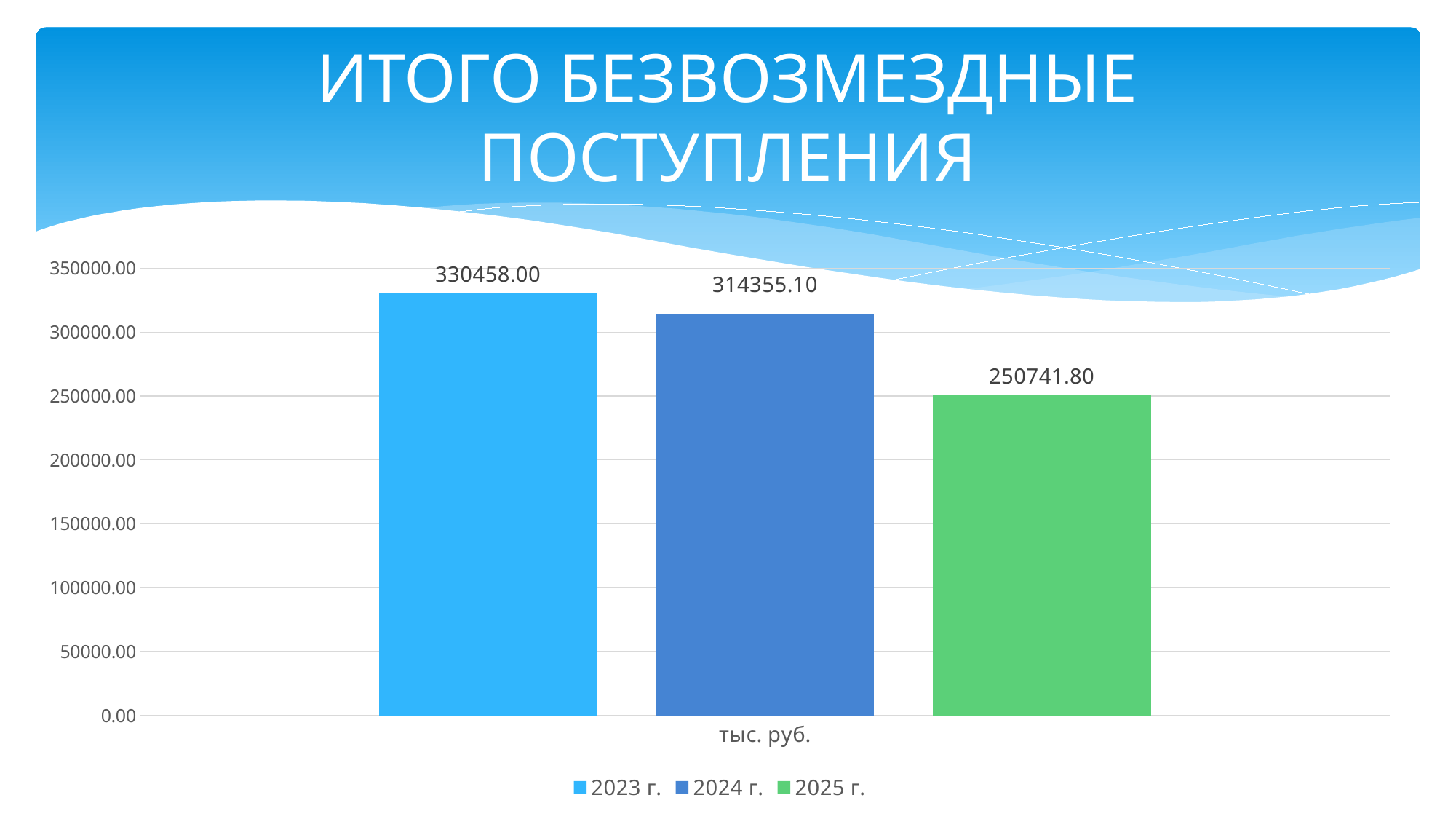
What is the value for 2023 г.? 330458.00 What is the difference between the values for 2023 г. and 2024 г.? 16102.90 What is the title of the chart? ИТОГО БЕЗВОЗМЕЗДНЫЕ ПОСТУПЛЕНИЯ Which is larger, the value for 2024 г. or the value for 2025 г.? 2024 г. What is the value for 2024 г.? 314355.10 What kind of chart is shown on the slide? bar chart What is the difference between the values for 2024 г. and 2025 г.? 63613.30 Which year has the lowest value? 2025 г. What is the value for 2025 г.? 250741.80 Which year has the highest value? 2023 г. How many series does the legend list? 3 Is the value for 2025 г. greater or less than 300000.00? less